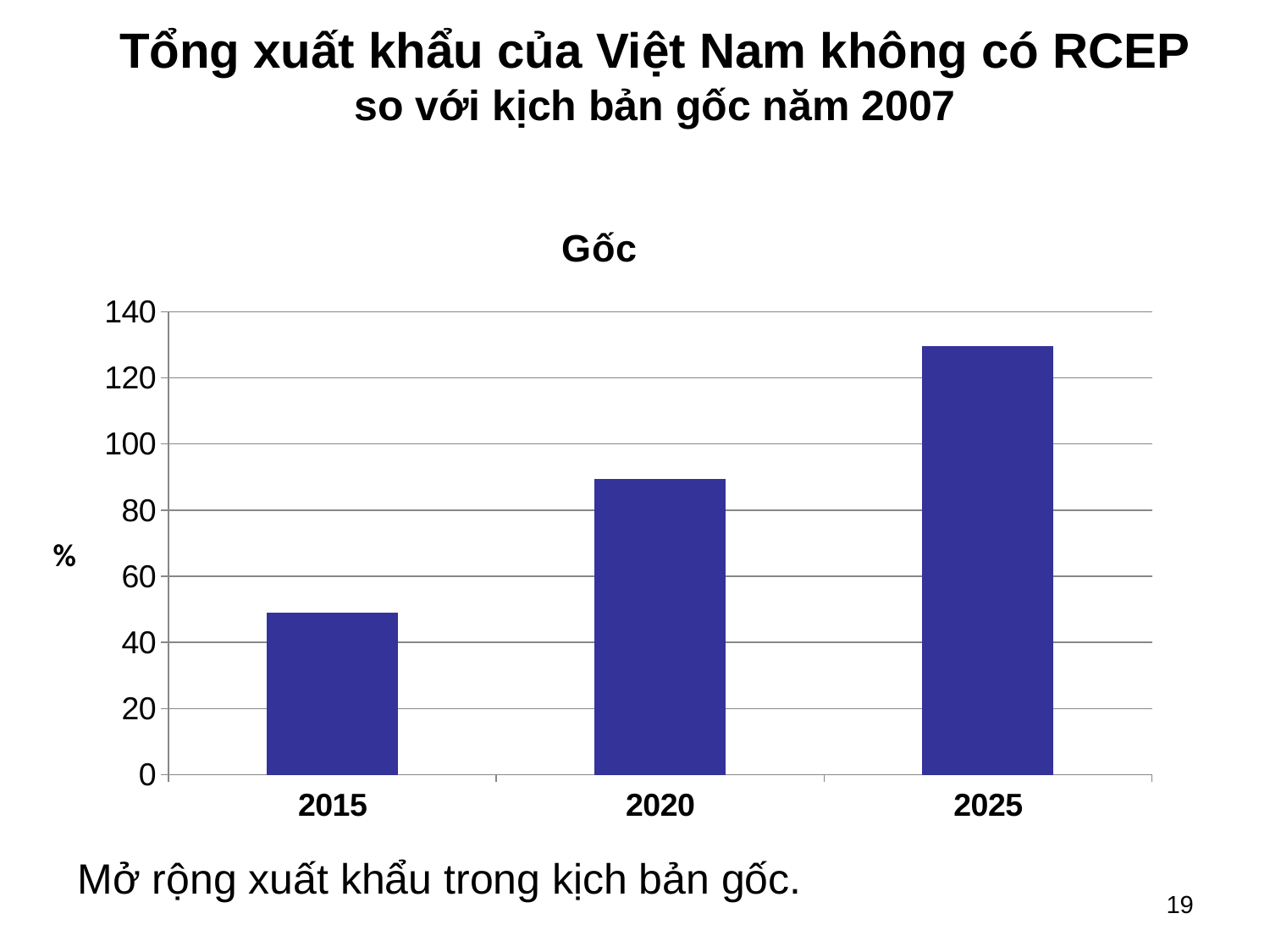
What is the title of the chart? Gốc Is the value for 2020 greater or less than 80? greater Which year has the highest value in the chart? 2025 Which is larger, the value for 2020 or the value for 2015? 2020 What kind of chart is shown on the slide? bar chart Is the value for 2015 greater or less than 60? less What is the label on the vertical axis of the chart? % Is the value for 2025 greater or less than 120? greater How many bars (categories) are plotted in the chart? 3 Which year has the lowest value in the chart? 2015 Do the values rise or fall from 2015 to 2025? rise